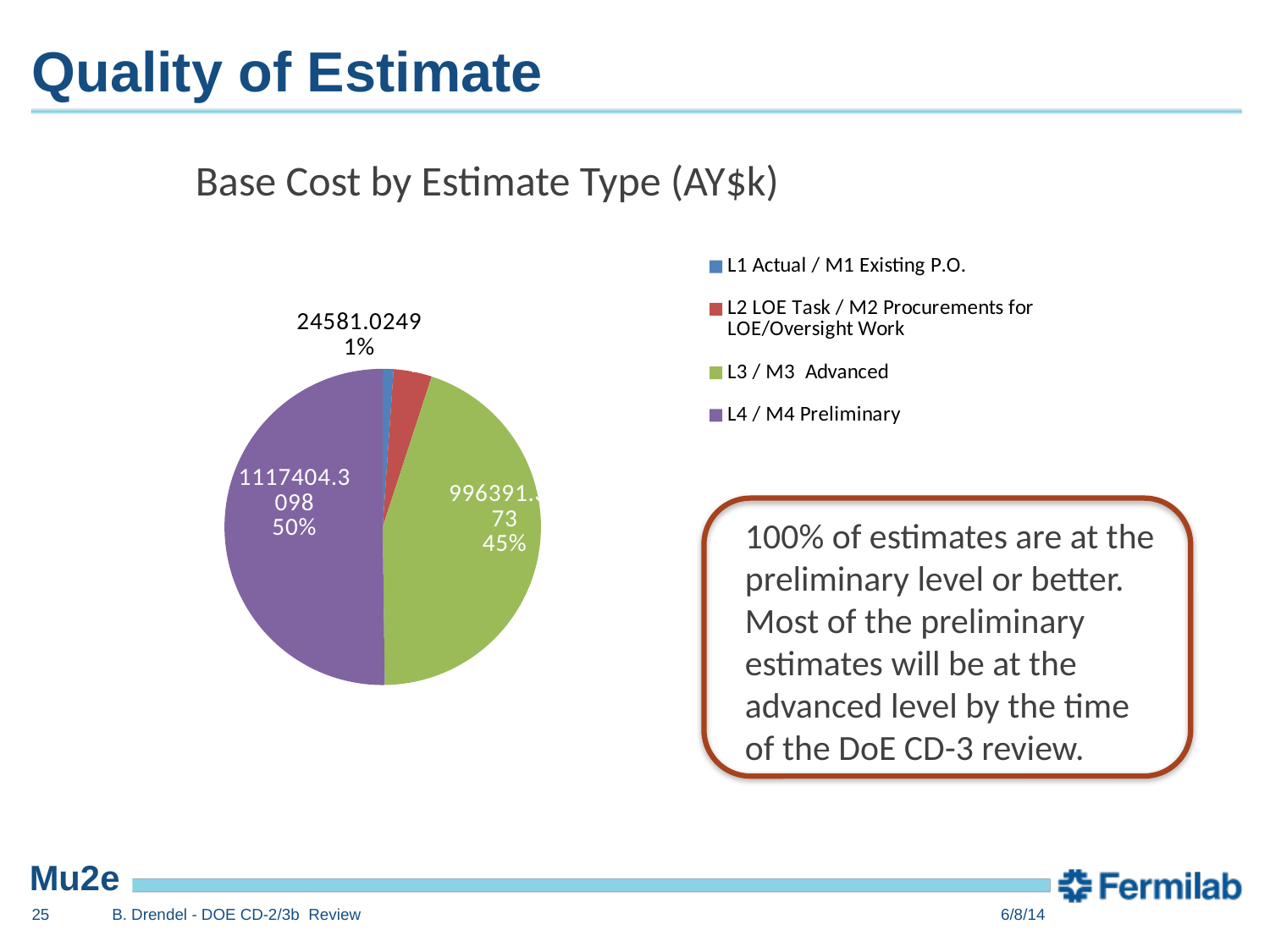
What share of the pie does L3 / M3 Advanced account for? 45% What is the base cost value shown for L4 / M4 Preliminary? 1117404.3098 What is the title of the chart? Base Cost by Estimate Type (AY$k) What share of the pie does L4 / M4 Preliminary account for? 50% Which estimate type has the largest slice of the pie? L4 / M4 Preliminary Which estimate type has the smallest slice of the pie? L1 Actual / M1 Existing P.O. What share of the pie does L1 Actual / M1 Existing P.O. account for? 1% What kind of chart is shown on the slide? pie chart How many estimate types does the chart's legend list? 4 What is the base cost value shown for L1 Actual / M1 Existing P.O.? 24581.0249 Which has the larger share: L3 / M3 Advanced or L4 / M4 Preliminary? L4 / M4 Preliminary By how many percentage points does the share of L4 / M4 Preliminary exceed that of L3 / M3 Advanced? 5